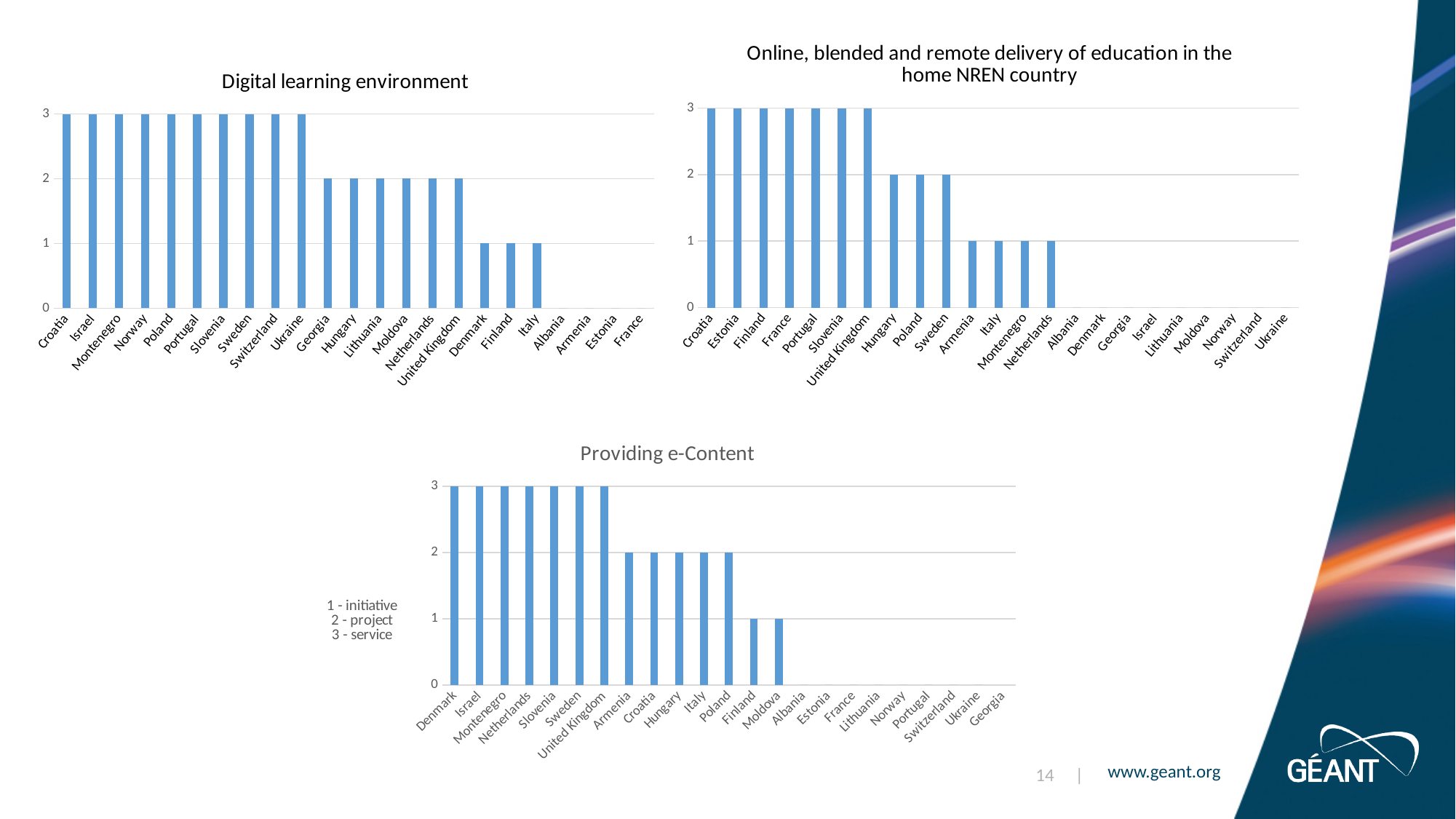
In the 'Online, blended and remote delivery of education in the home NREN country' chart, what is the value for Sweden? 2 According to the key next to the 'Providing e-Content' chart, what does a value of 3 stand for? service In the 'Providing e-Content' chart, what is the value for Croatia? 2 In the 'Digital learning environment' chart, what is the value for Georgia? 2 In the 'Online, blended and remote delivery of education in the home NREN country' chart, what is the value for Netherlands? 1 In the 'Digital learning environment' chart, what is the value for Finland? 1 In the 'Digital learning environment' chart, what is the difference between the values for Ukraine and Italy? 2 In the 'Providing e-Content' chart, which is larger, the value for Denmark or the value for Finland? Denmark In the 'Providing e-Content' chart, what is the value for Moldova? 1 In the 'Online, blended and remote delivery of education in the home NREN country' chart, which is larger, the value for Estonia or the value for Hungary? Estonia What kind of chart is 'Providing e-Content'? Bar chart In the 'Digital learning environment' chart, how many countries are listed on the x axis? 23